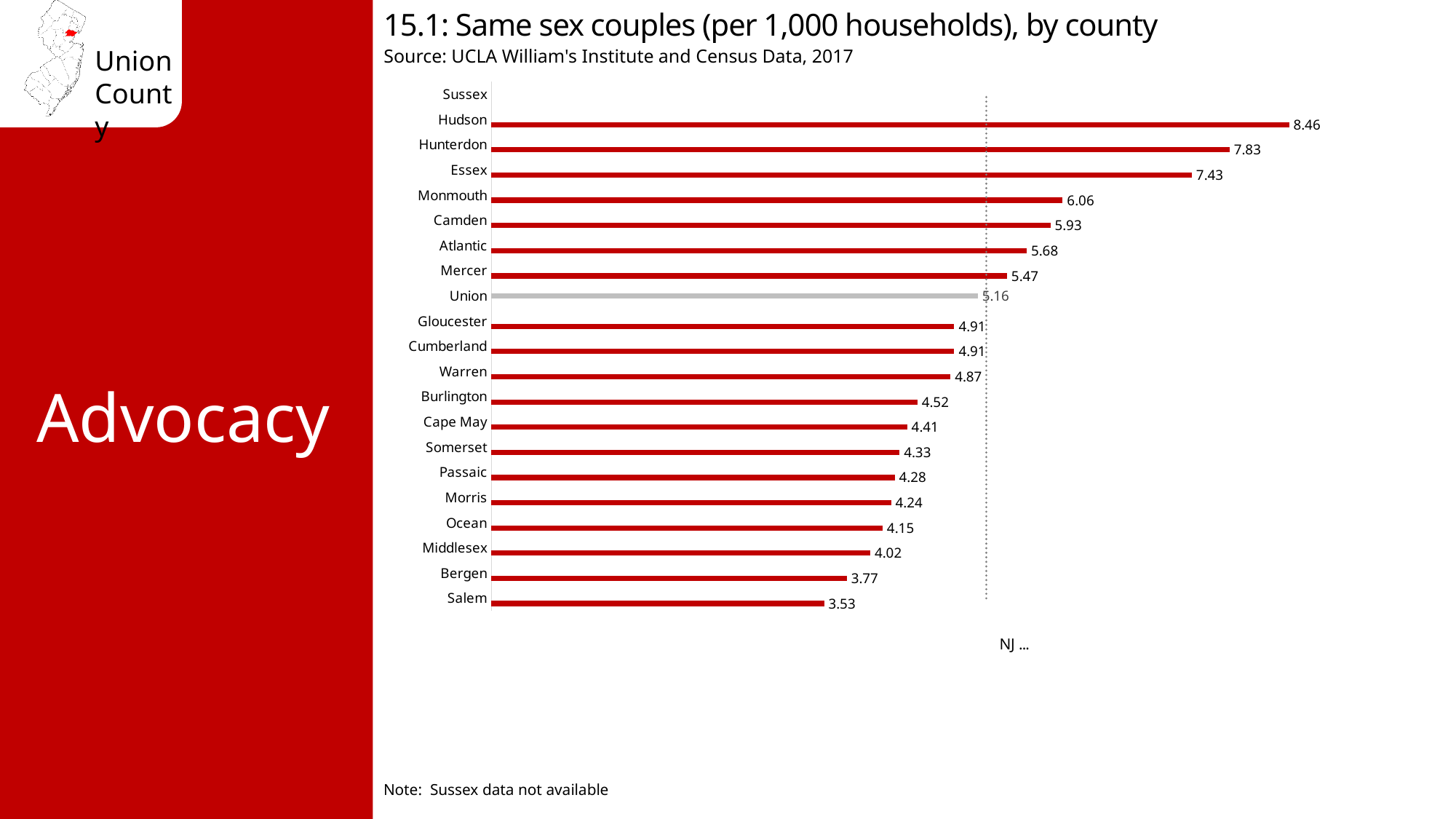
Which county with data shown has the lowest value? Salem What kind of chart is shown on the slide? Bar chart Which county has the highest value of same sex couples per 1,000 households? Hudson Which has a larger value, Monmouth or Camden? Monmouth What is the value for Union County in the chart? 5.16 Which county's bar is shown in grey instead of red? Union What is the difference between the values for Union and Salem? 1.63 How many counties are listed on the vertical axis of the chart? 21 What is the value for Hudson County? 8.46 What is the value for Salem County? 3.53 What is the value for Cape May County? 4.41 What is the difference between the values for Hudson and Hunterdon? 0.63